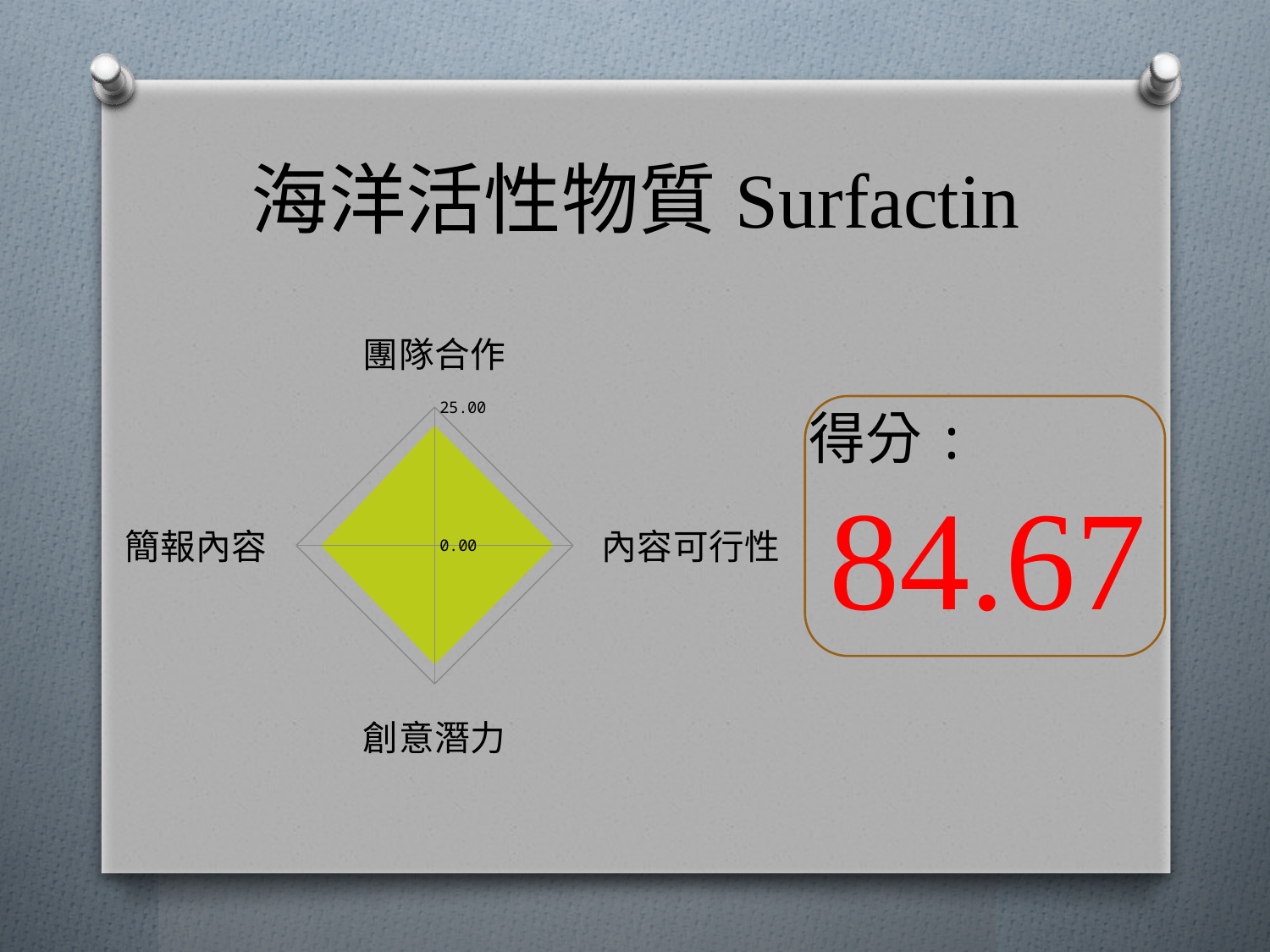
What is the maximum axis value shown on the radar chart? 25.00 Is the value for 團隊合作 greater or less than 0.00? greater How many categories (axes) does the radar chart have? 4 Is the value for 創意潛力 greater or less than 0.00? greater Which category is at the top of the radar chart? 團隊合作 What kind of chart is shown on the slide? radar chart What is the axis value shown at the centre of the radar chart? 0.00 Which category is on the right side of the radar chart? 內容可行性